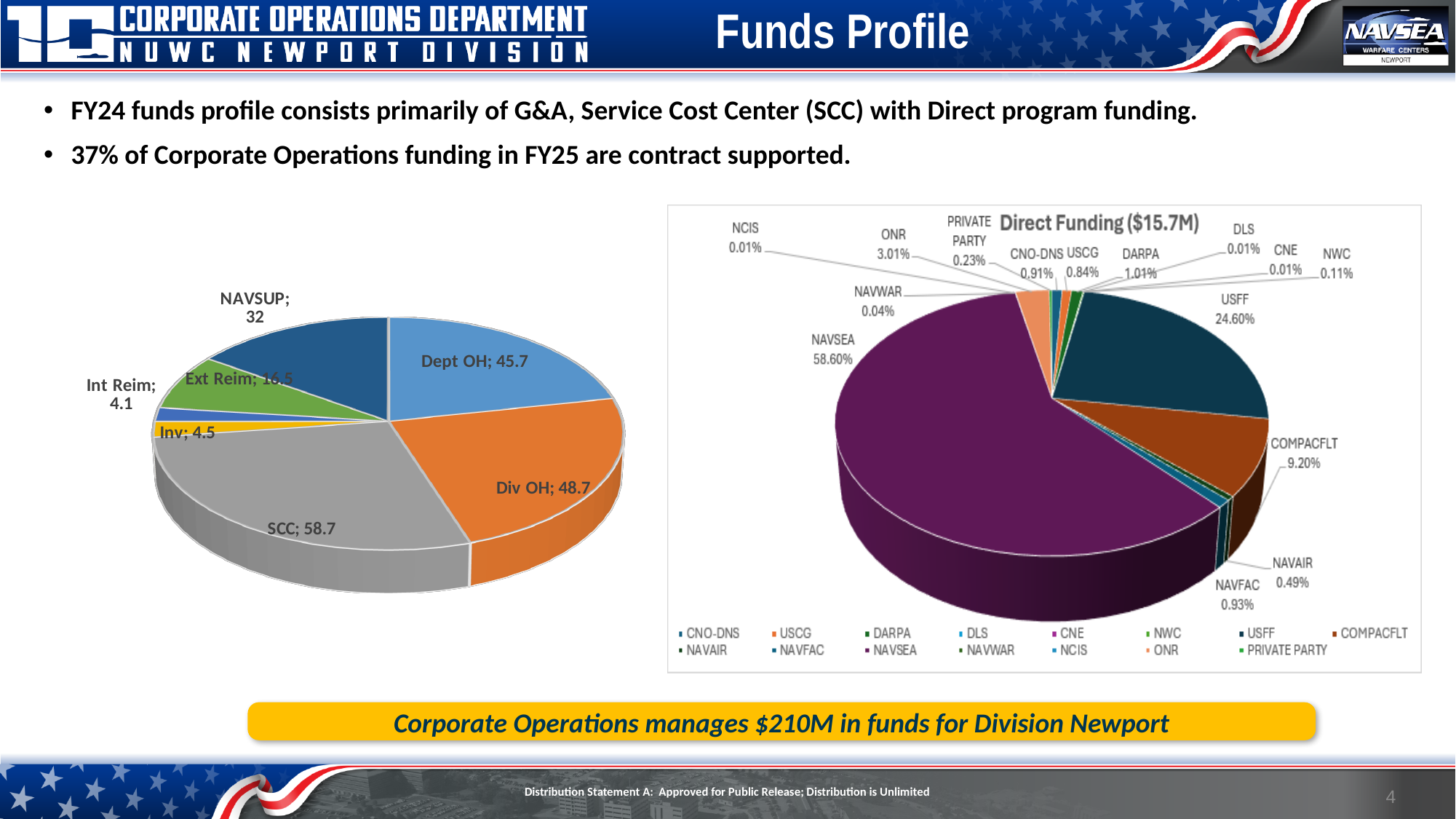
On the left pie chart, what is the value for SCC? 58.7 On the Direct Funding ($15.7M) chart, what share does USFF have? 24.60% What kind of chart is the Direct Funding ($15.7M) chart? Pie chart On the Direct Funding ($15.7M) chart, which is larger, COMPACFLT or ONR? COMPACFLT How many entries does the legend of the Direct Funding ($15.7M) chart list? 15 On the left pie chart, which category has the largest value? SCC On the left pie chart, which category has the smallest value? Int Reim On the left pie chart, what is the difference between the values for Div OH and Dept OH? 3 On the Direct Funding ($15.7M) chart, what share does NAVSEA have? 58.60% On the left pie chart, what is the value for Dept OH? 45.7 On the left pie chart, which is larger, NAVSUP or Ext Reim? NAVSUP How many categories are shown on the left pie chart? 7